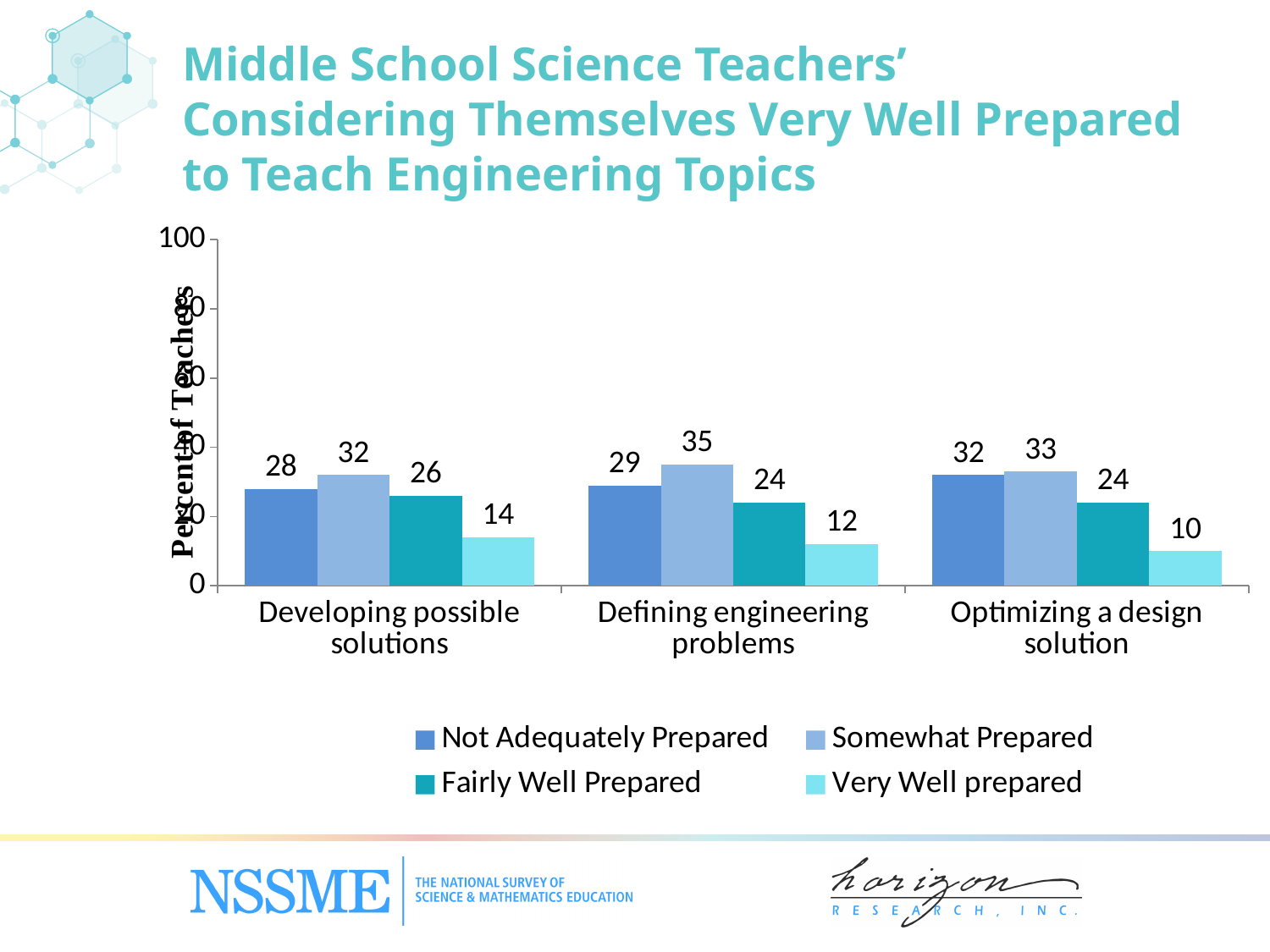
What is the value for Somewhat Prepared in the Defining engineering problems category? 35 How many categories are shown on the x axis? 3 What is the label of the vertical axis? Percent of Teachers What is the difference between the Somewhat Prepared and Very Well prepared values in the Defining engineering problems category? 23 Which is larger: Fairly Well Prepared for Developing possible solutions or Fairly Well Prepared for Optimizing a design solution? Developing possible solutions What is the value for Very Well prepared in the Optimizing a design solution category? 10 Which category has the lowest value for Not Adequately Prepared? Developing possible solutions What is the value for Not Adequately Prepared in the Developing possible solutions category? 28 What kind of chart is shown on the slide? bar chart Is the value for Somewhat Prepared in the Optimizing a design solution category greater or less than 40? less Which category has the highest value for Very Well prepared? Developing possible solutions How many series does the legend list? 4